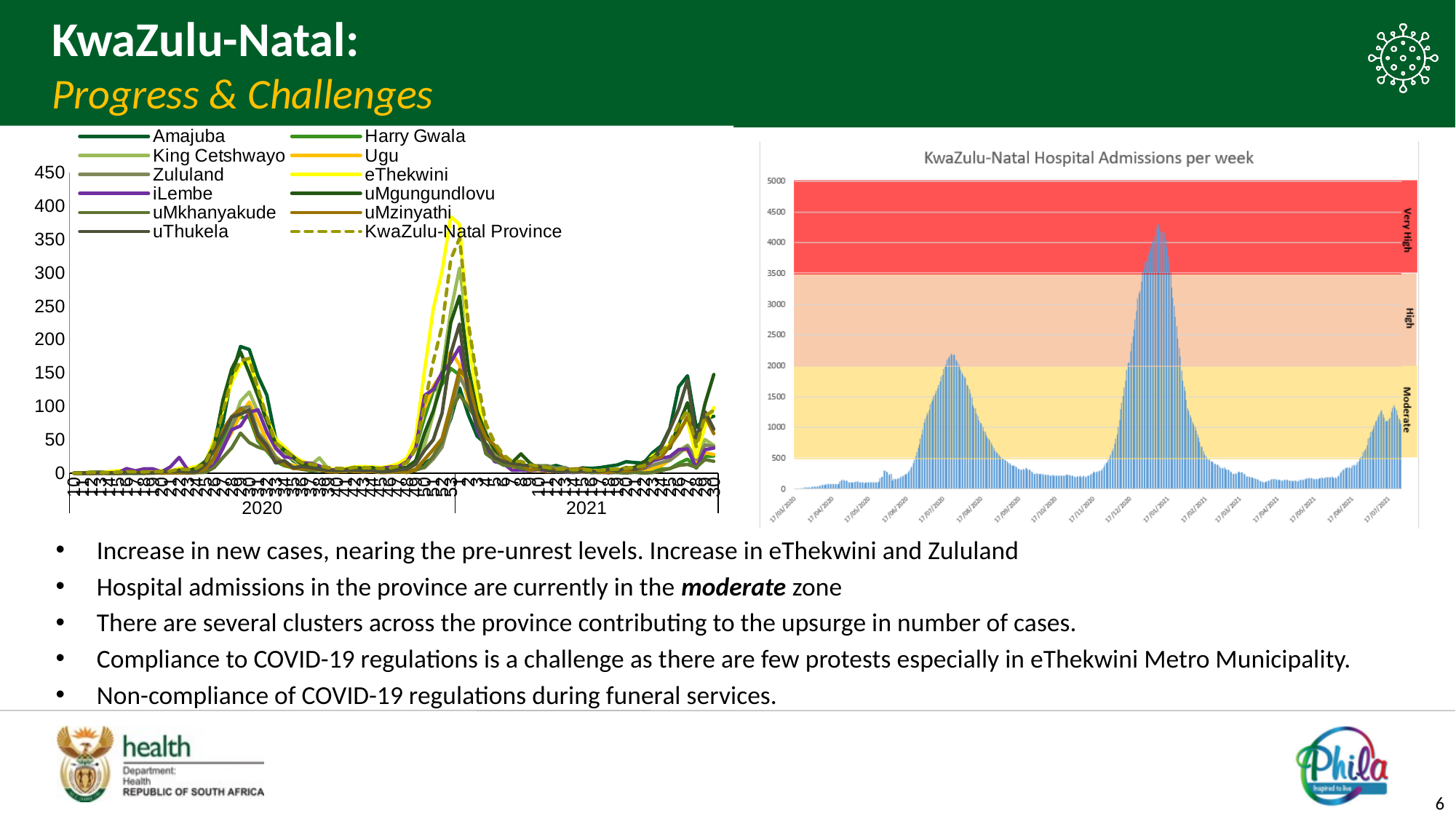
What is the title of the right chart? KwaZulu-Natal Hospital Admissions per week In the KwaZulu-Natal Hospital Admissions per week chart, which of the two peaks is larger: the mid-2020 peak or the January 2021 peak? January 2021 peak In the left chart, is the highest peak of the eThekwini series greater or less than 350? greater What kind of chart is the KwaZulu-Natal Hospital Admissions per week chart? bar chart How many series does the legend of the left chart list? 12 In the KwaZulu-Natal Hospital Admissions per week chart, is the highest peak (around January 2021) greater or less than 4000? greater Which two years are labelled on the x axis of the left chart? 2020 and 2021 In the left chart, which series is drawn with a dashed line? KwaZulu-Natal Province In the KwaZulu-Natal Hospital Admissions per week chart, is the mid-2020 peak greater or less than 2500? less What kind of chart is the left chart showing cases by district? line chart In the left chart, which district series reaches the highest peak? eThekwini